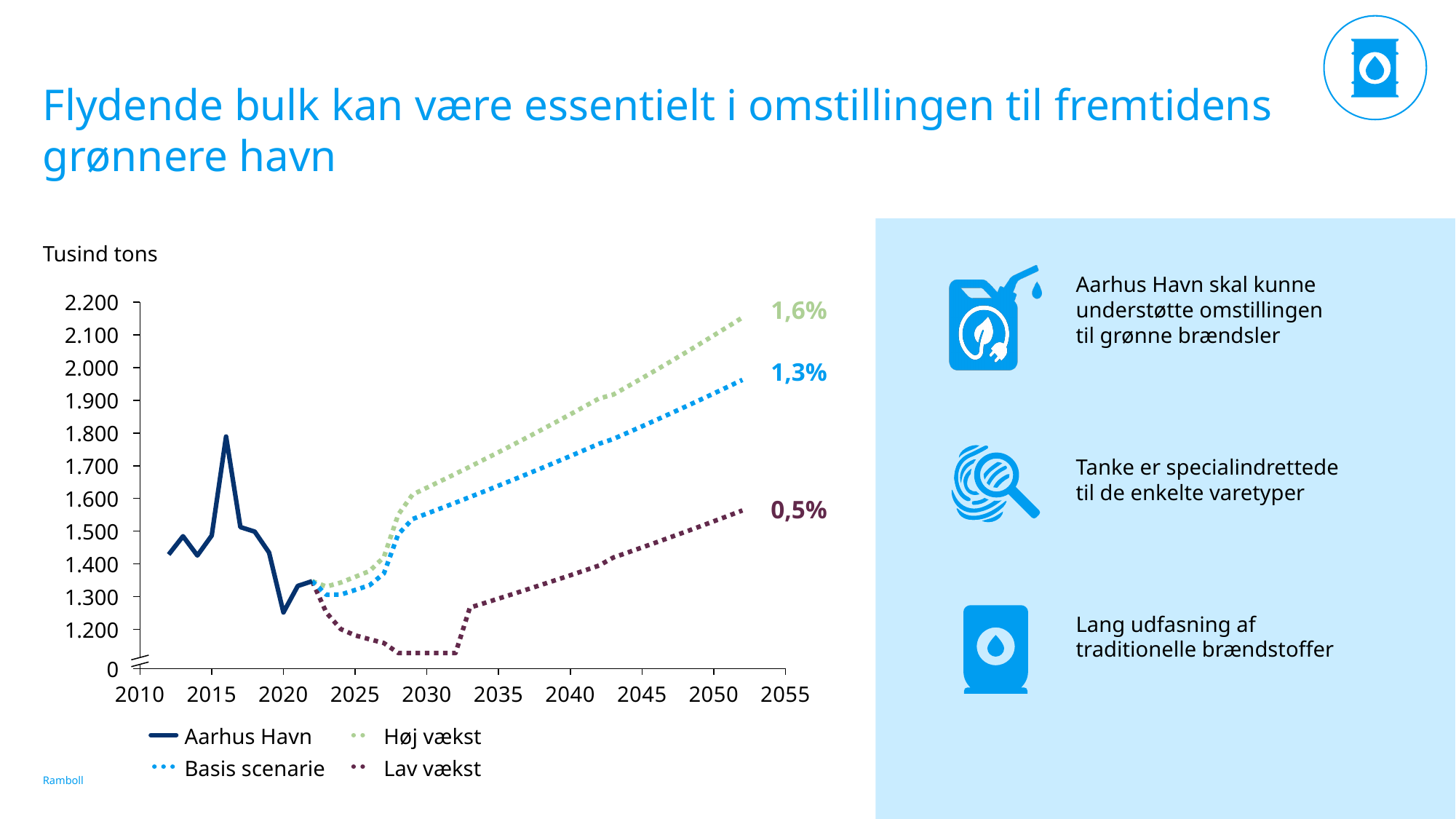
How many series does the chart legend list? 4 Which series has the lowest value at the end of the chart (around 2052)? Lav vækst What growth rate is printed next to the Basis scenarie line? 1,3% What growth rate is printed next to the Høj vækst line? 1,6% Does the Basis scenarie line rise or fall between 2030 and 2052? rise Which series has the highest value at the end of the chart (around 2052)? Høj vækst Is the value of the Lav vækst line around 2030 greater or less than 1.200? less What unit label is shown above the y axis of the chart? Tusind tons What kind of chart is shown on the slide? line chart Is the peak value of the Aarhus Havn line around 2016 greater or less than 1.700? greater Is the value of the Høj vækst line in 2052 greater or less than 2.100? greater What growth rate is printed next to the Lav vækst line? 0,5%